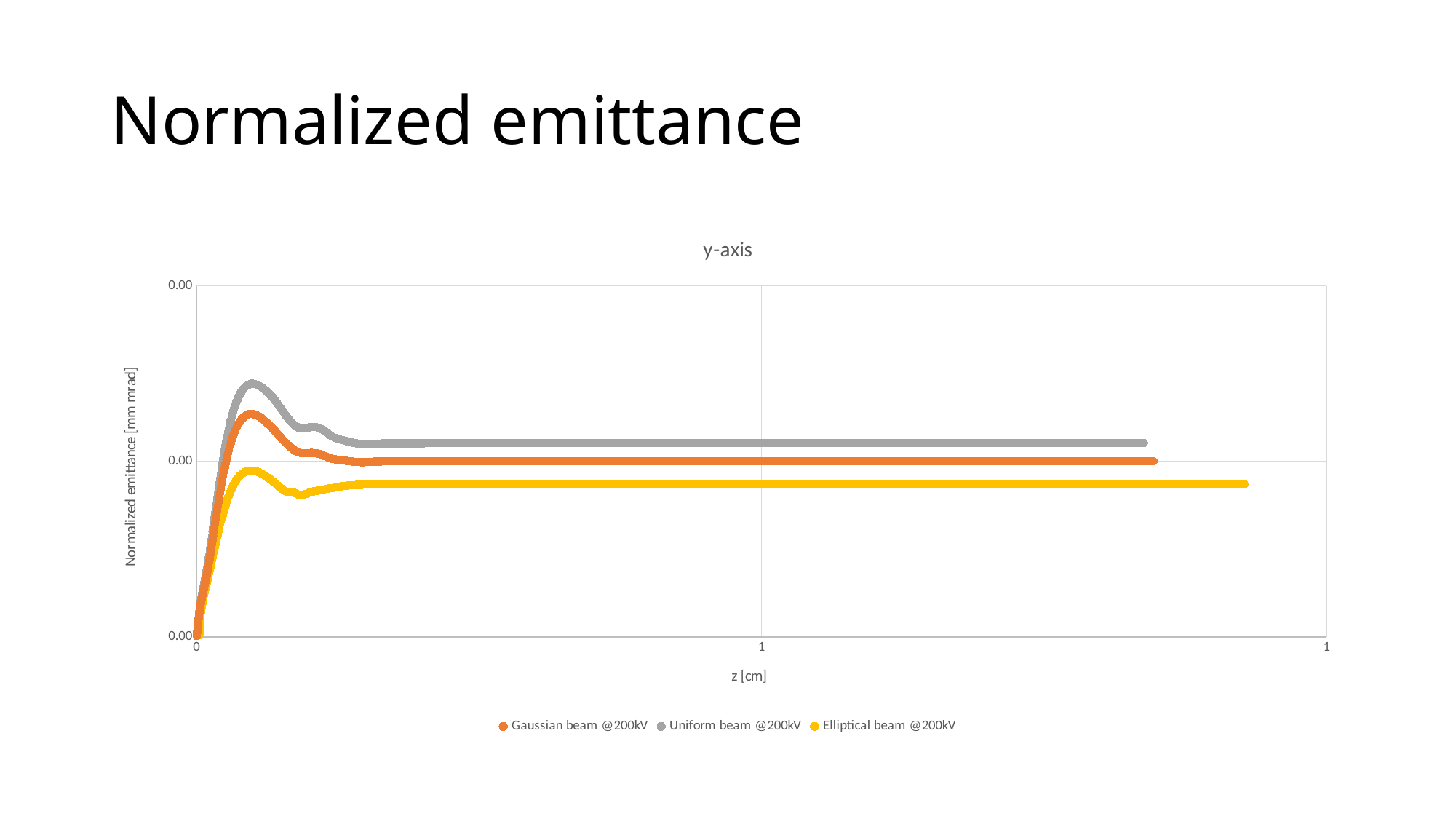
Which series has the lowest values along the chart? Elliptical beam @200kV After its initial peak, does the Gaussian beam @200kV series rise or fall before levelling off? fall Do the values of the Uniform beam @200kV series rise or fall at the very start of the x axis? rise Which series is higher in the flat region of the chart, Gaussian beam @200kV or Elliptical beam @200kV? Gaussian beam @200kV Which series ends earliest along the x axis? Uniform beam @200kV What is the title of the chart? y-axis Which series reaches the highest peak value? Uniform beam @200kV Which series extends furthest along the x axis? Elliptical beam @200kV What kind of chart is shown on the slide? line chart How many series does the legend list? 3 What is the label of the x axis? z [cm]